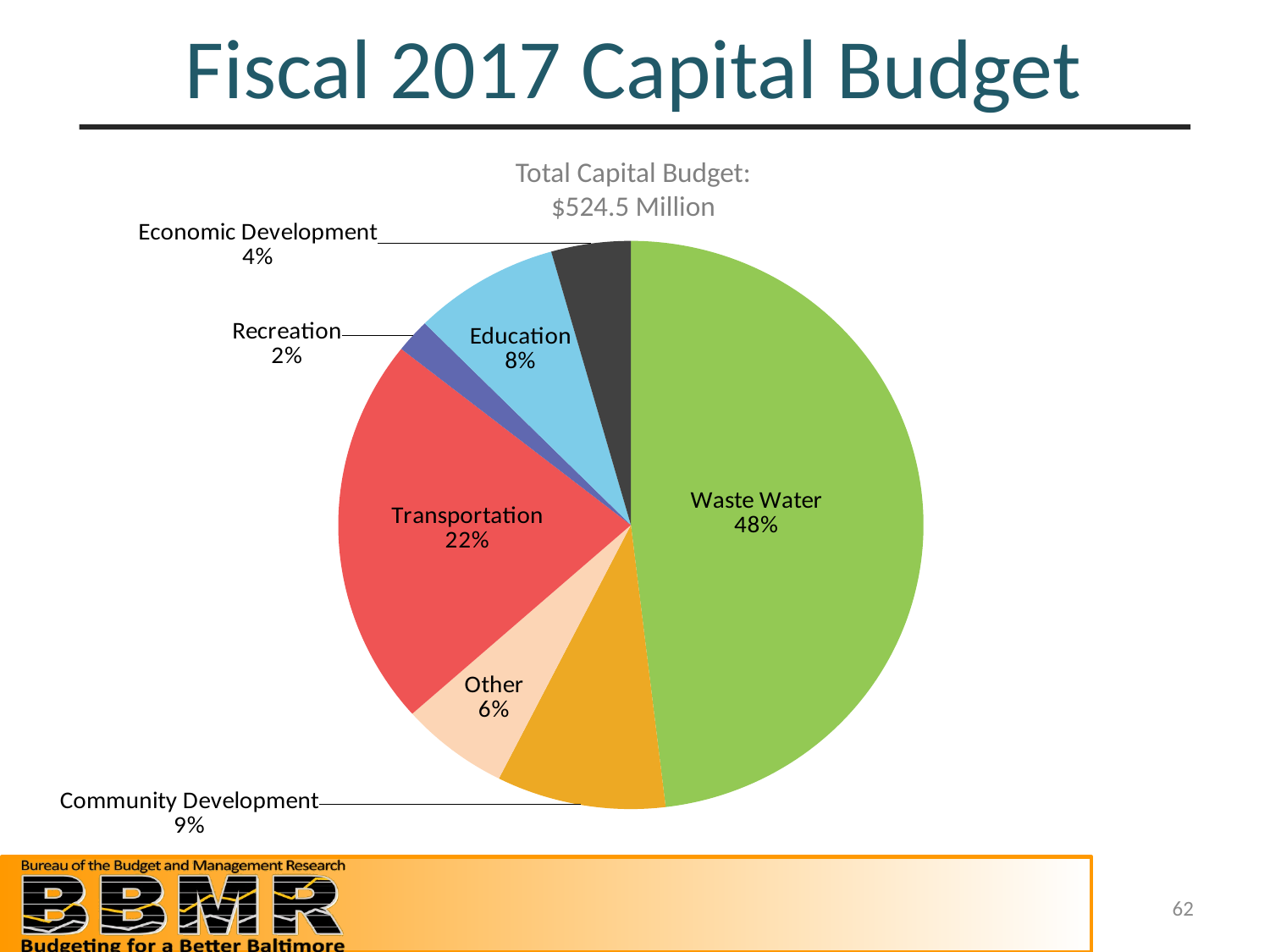
Which category has the smallest slice of the pie? Recreation What share of the capital budget goes to Transportation? 22% What total capital budget is stated in the chart title? $524.5 Million What percentage is shown for Education? 8% How many slices does the pie chart have? 7 Which is larger, the share for Economic Development or the share for Other? Other Which category has the largest slice of the pie? Waste Water What share of the capital budget goes to Waste Water? 48% What is the difference in percentage points between Waste Water and Transportation? 26 What percentage is shown for Recreation? 2% What kind of chart is shown on the slide? pie chart What percentage is shown for Community Development? 9%